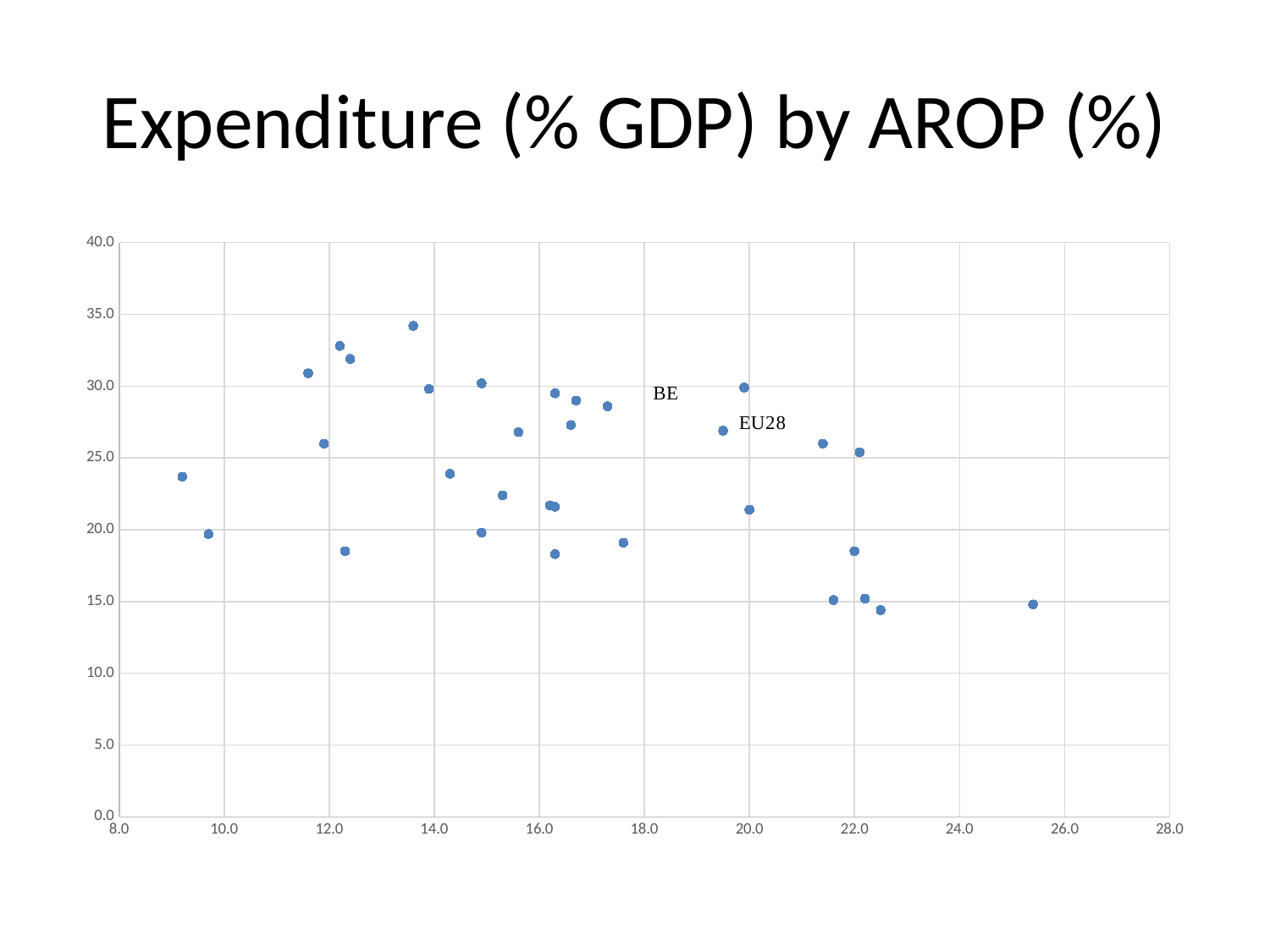
Is the AROP value of the rightmost point on the chart greater or less than 24.0? greater What kind of chart is shown on the slide? scatter chart What is the maximum value shown on the vertical axis? 40.0 Is the highest expenditure value plotted on the chart greater or less than 30.0? greater Is the expenditure value for EU28 greater or less than 30.0? less Overall, do the expenditure values tend to rise or fall as AROP increases along the x axis? fall What is the title of the chart? Expenditure (% GDP) by AROP (%) Which two points on the chart are labelled with text? BE and EU28